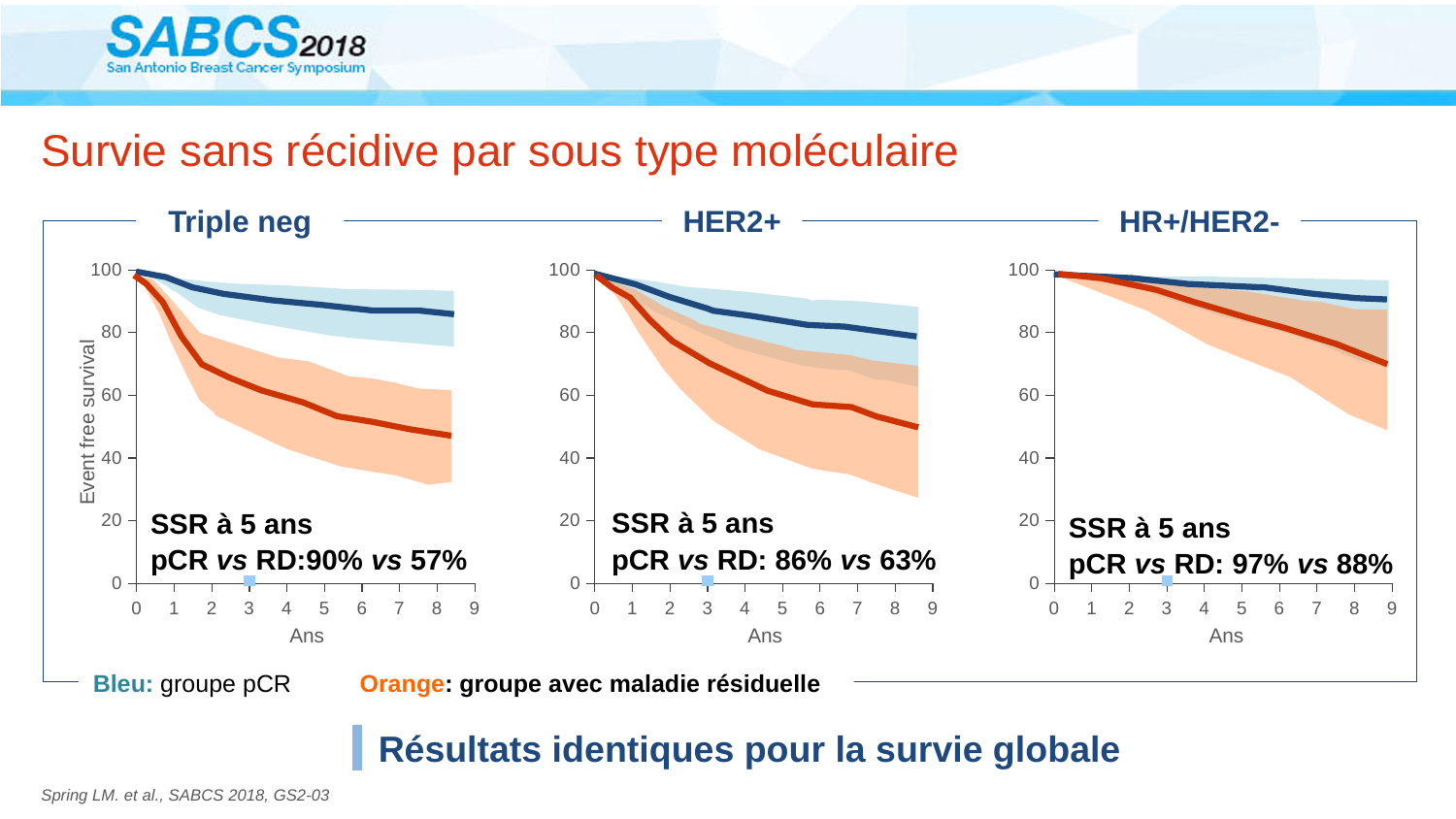
Across the three charts, which molecular subtype has the highest SSR à 5 ans for the pCR group? HR+/HER2- According to the legend, which group does the blue curve represent? groupe pCR Across the three charts, which molecular subtype has the lowest SSR à 5 ans for the RD group? Triple neg In the HER2+ chart, do the curves rise or fall as the years increase? fall In the Triple neg chart, is the orange curve at 8 years greater or less than 60? less In the HER2+ chart, what is the difference between the 5-year SSR of the pCR group and the RD group? 23% In the Triple neg chart, what is the SSR à 5 ans for the pCR group? 90% What kind of chart is used for the Triple neg panel? line chart In the Triple neg chart, what is the SSR à 5 ans for the RD group? 57% In the HR+/HER2- chart, what is the SSR à 5 ans for the RD group? 88% In the HER2+ chart, what is the SSR à 5 ans for the pCR group? 86% In the HR+/HER2- chart, what is the difference between the 5-year SSR of the pCR group and the RD group? 9%